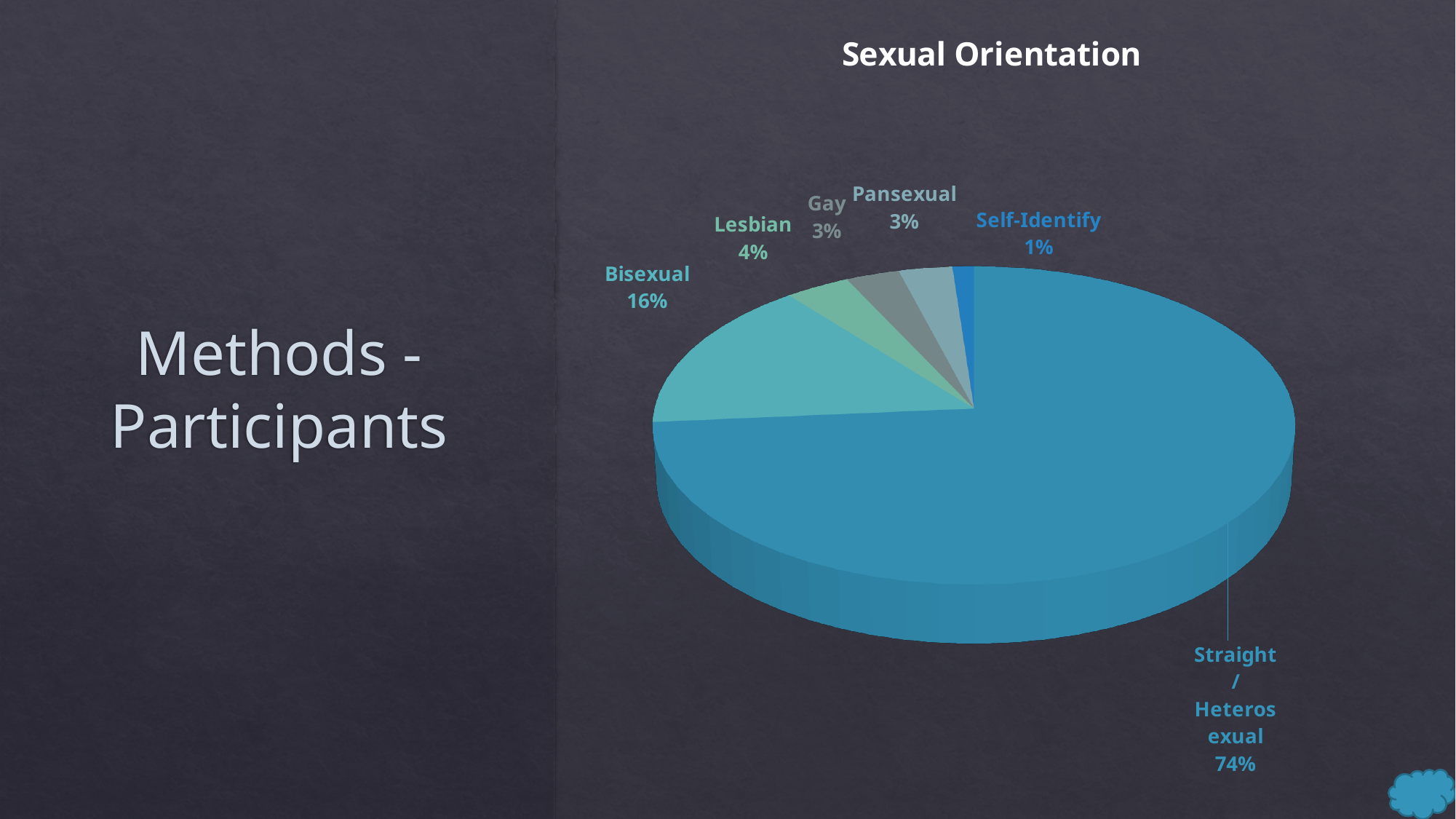
What percentage of participants chose Self-Identify? 1% What percentage of participants identified as Pansexual? 3% What is the title of the chart? Sexual Orientation What percentage of participants identified as Straight/Heterosexual? 74% How many categories are shown in the pie chart? 6 What percentage of participants identified as Bisexual? 16% What type of chart is shown on the slide? Pie chart Which category has the largest share of the pie? Straight/Heterosexual What is the difference between the Straight/Heterosexual share and the Bisexual share? 58% Which category has the smallest share of the pie? Self-Identify What percentage of participants identified as Lesbian? 4% Which is larger, the Bisexual share or the Lesbian share? Bisexual